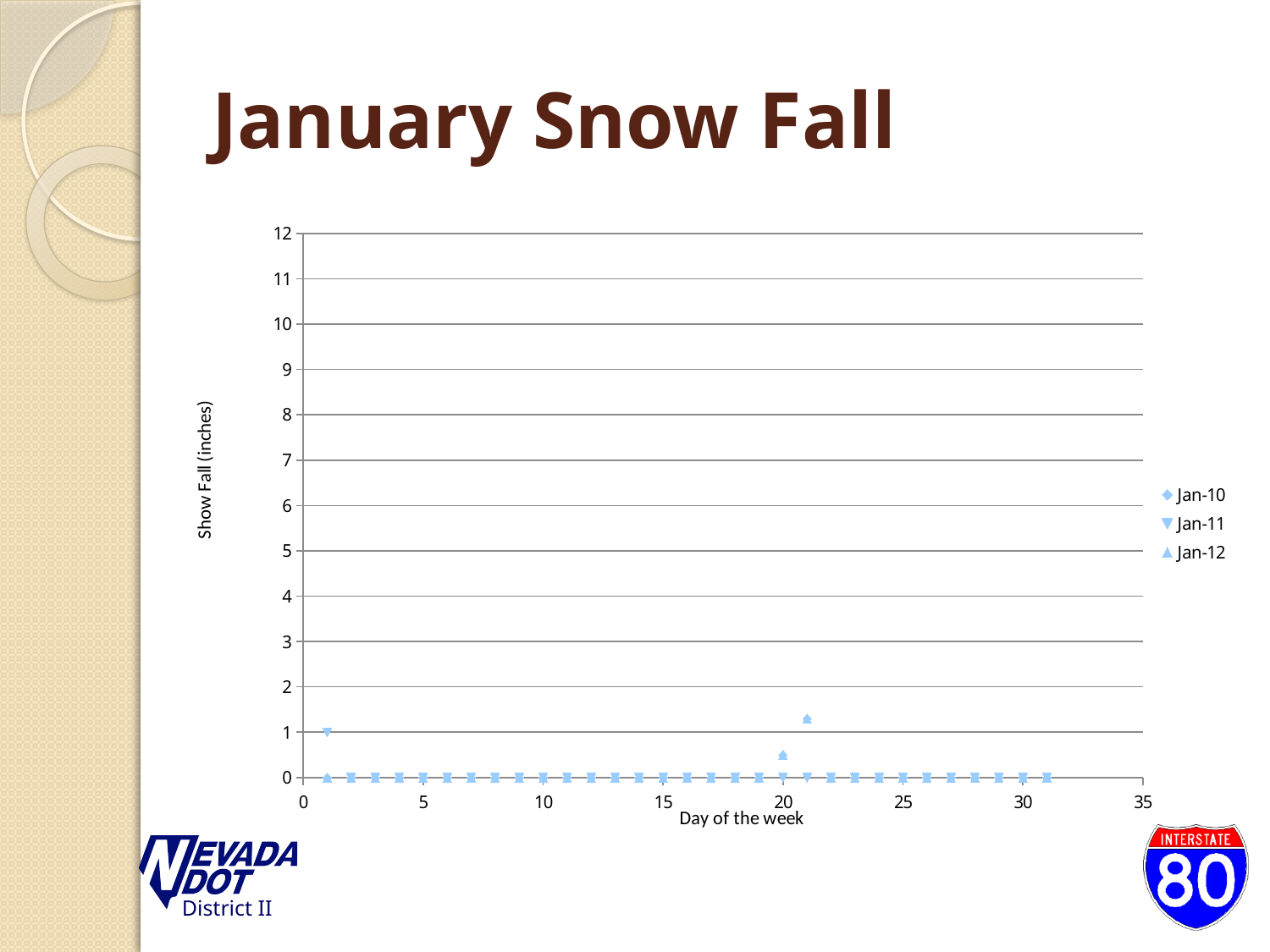
What is the title of the chart? January Snow Fall What is the snow fall value for Jan-10 on day 10? 0 Is the Jan-12 value on day 21 greater or less than 2? less Is the Jan-12 value on day 21 greater or less than 1? greater What is the snow fall value for Jan-11 on day 1? 1 How many series does the legend list? 3 Is the Jan-12 value on day 20 greater or less than 1? less Which is larger: the Jan-12 value on day 21 or the Jan-11 value on day 1? Jan-12 value on day 21 What is the highest value shown on the y axis? 12 What kind of chart is shown on the slide? scatter chart What are the series names listed in the legend? Jan-10, Jan-11, Jan-12